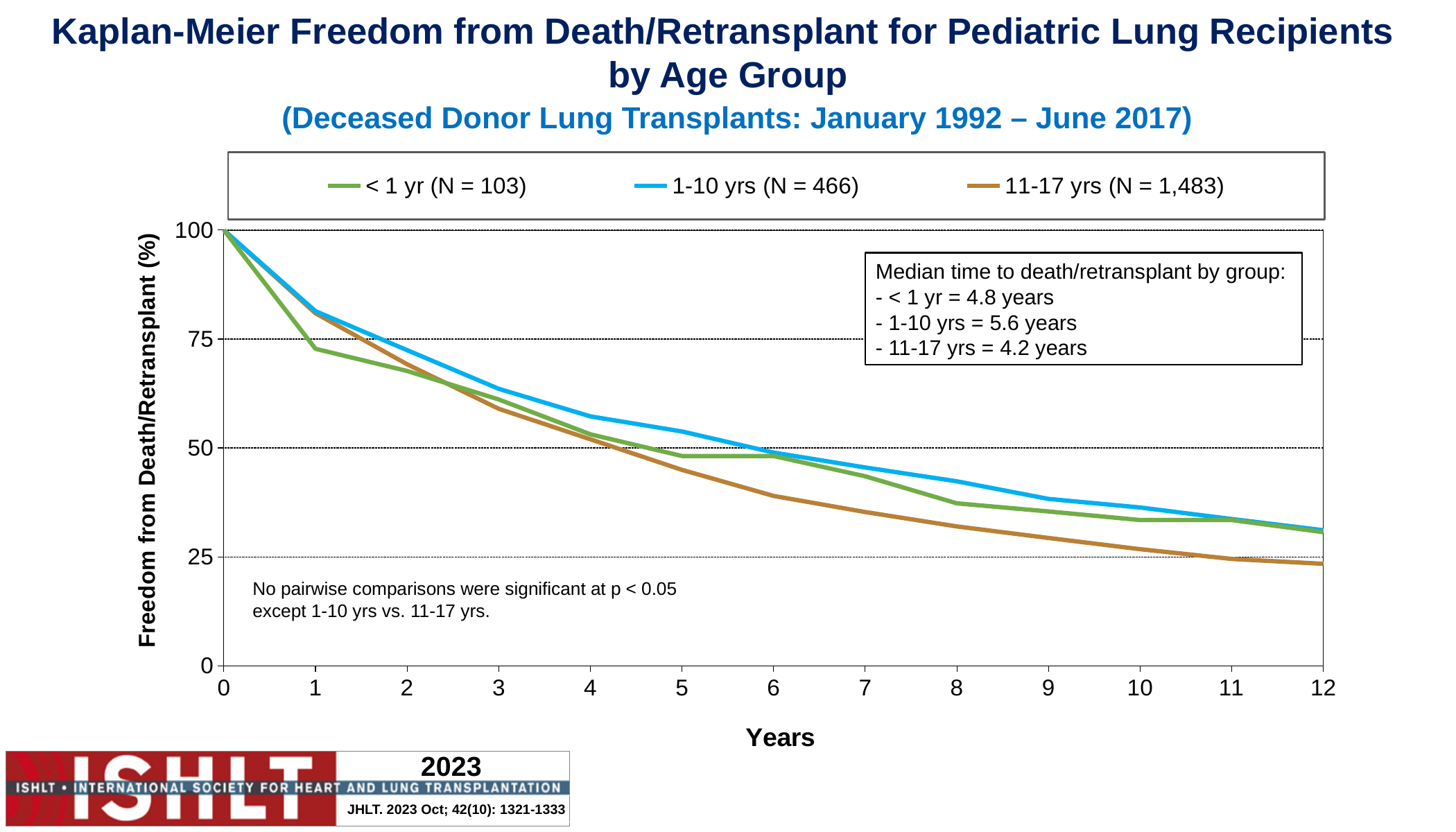
How many series does the legend list? 3 According to the text box, what is the median time to death/retransplant for the 1-10 yrs group? 5.6 years According to the text box, what is the median time to death/retransplant for the < 1 yr group? 4.8 years According to the text box, what is the median time to death/retransplant for the 11-17 yrs group? 4.2 years Which age group has the lowest freedom from death/retransplant at 12 years? 11-17 yrs Is the freedom from death/retransplant for the 11-17 yrs group at 12 years greater or less than 25? less What is the N for the 11-17 yrs group shown in the legend? 1,483 What kind of chart is shown on the slide? line chart Is the freedom from death/retransplant for the 11-17 yrs group at 6 years greater or less than 50? less At 8 years, which group has higher freedom from death/retransplant, 1-10 yrs or 11-17 yrs? 1-10 yrs Do the freedom from death/retransplant values rise or fall as years increase? fall Is the freedom from death/retransplant for the 1-10 yrs group at 1 year greater or less than 75? greater